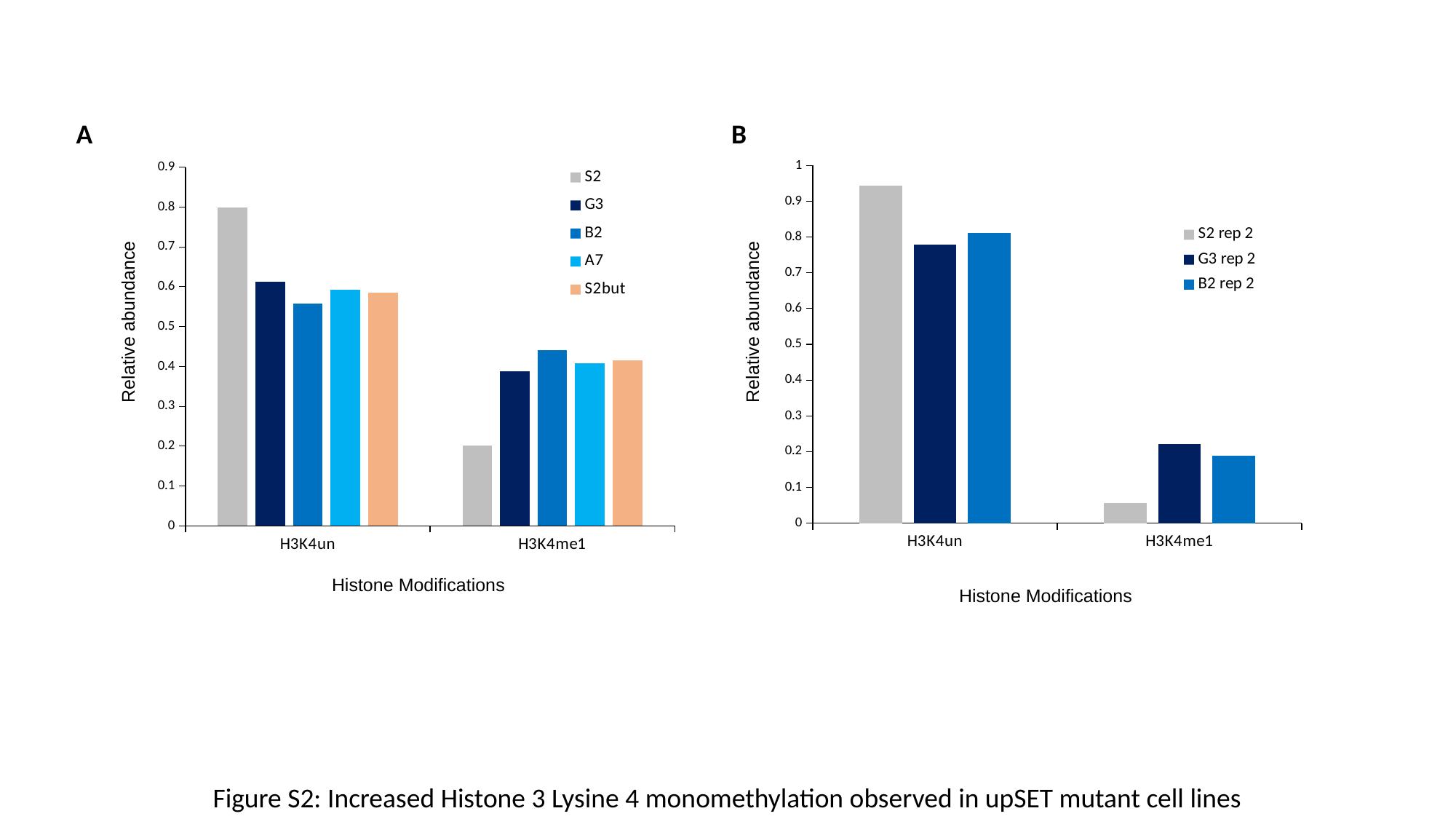
In chart B (right), is the value of S2 rep 2 for H3K4me1 greater or less than 0.1? less What is the y-axis title of chart B (right)? Relative abundance In chart A (left), which series has the lowest value for H3K4me1? S2 In chart A (left), which is larger for S2: the value for H3K4un or the value for H3K4me1? H3K4un In chart A (left), is the value of S2 for H3K4un greater or less than 0.7? greater How many series does the legend of chart A (left) list? 5 In chart B (right), which series has the highest value for H3K4un? S2 rep 2 How many categories are shown on the x axis of chart B (right)? 2 In chart A (left), which series has the highest value for H3K4un? S2 In chart B (right), which series has the lowest value for H3K4me1? S2 rep 2 How many series does the legend of chart B (right) list? 3 What kind of chart is chart A on the left? bar chart